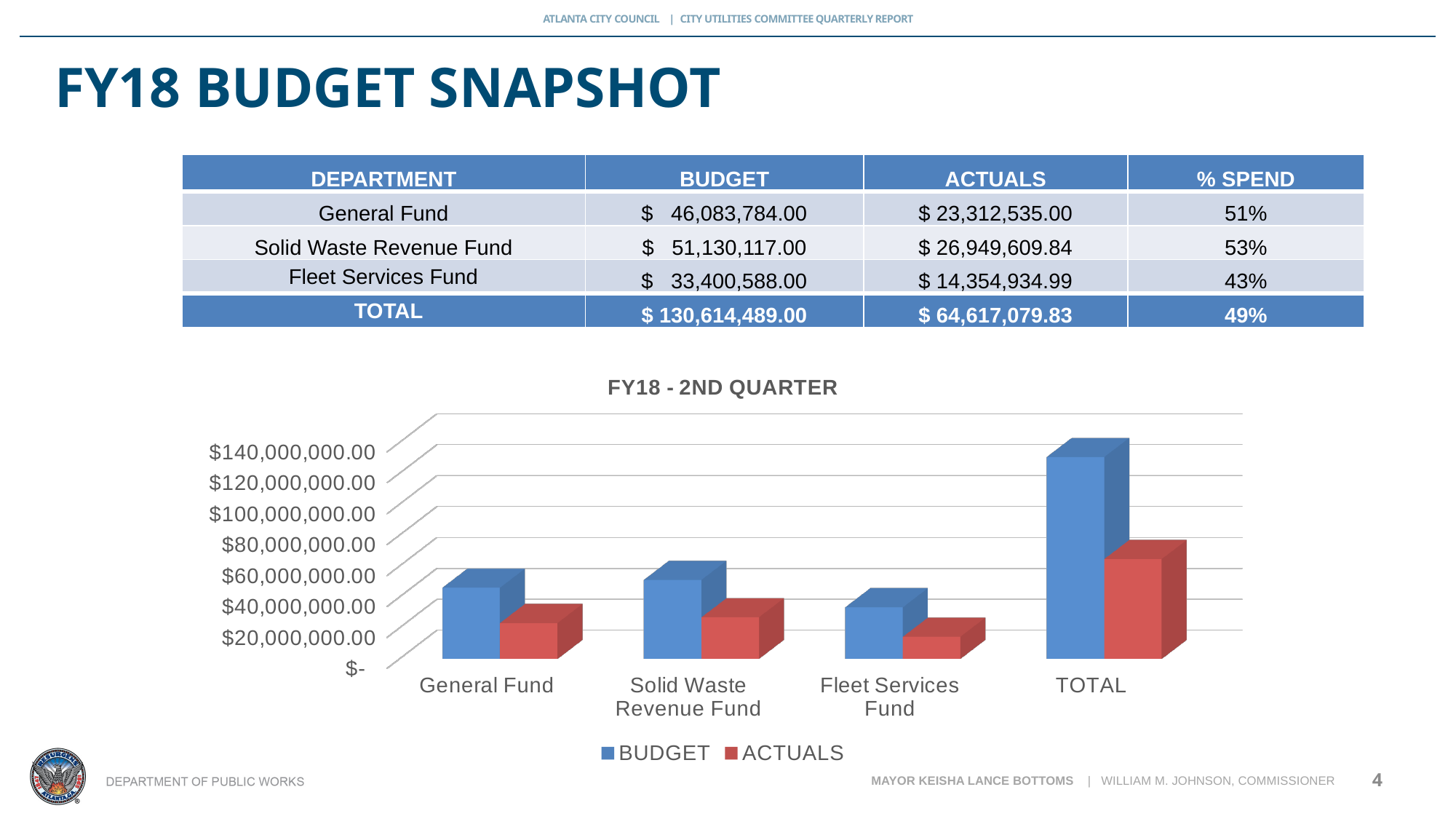
Which category has the tallest BUDGET bar in the FY18 - 2ND QUARTER chart? TOTAL In the FY18 - 2ND QUARTER chart, which is larger: the BUDGET bar for Solid Waste Revenue Fund or the BUDGET bar for General Fund? Solid Waste Revenue Fund In the FY18 - 2ND QUARTER chart, is the BUDGET bar for Fleet Services Fund greater or less than $40,000,000.00? less According to the table, what is the ACTUALS value for Fleet Services Fund plotted in the FY18 - 2ND QUARTER chart? $ 14,354,934.99 Which colour represents the ACTUALS series in the FY18 - 2ND QUARTER chart? Red Which category has the shortest ACTUALS bar in the FY18 - 2ND QUARTER chart? Fleet Services Fund What kind of chart is shown under the title 'FY18 - 2ND QUARTER'? Bar chart In the FY18 - 2ND QUARTER chart, is the BUDGET bar for TOTAL greater or less than $120,000,000.00? greater In the FY18 - 2ND QUARTER chart, is the ACTUALS bar for TOTAL greater or less than $80,000,000.00? less How many series does the legend of the FY18 - 2ND QUARTER chart list? 2 How many categories are shown on the x axis of the FY18 - 2ND QUARTER chart? 4 According to the table, what is the BUDGET value for Solid Waste Revenue Fund plotted in the FY18 - 2ND QUARTER chart? $ 51,130,117.00